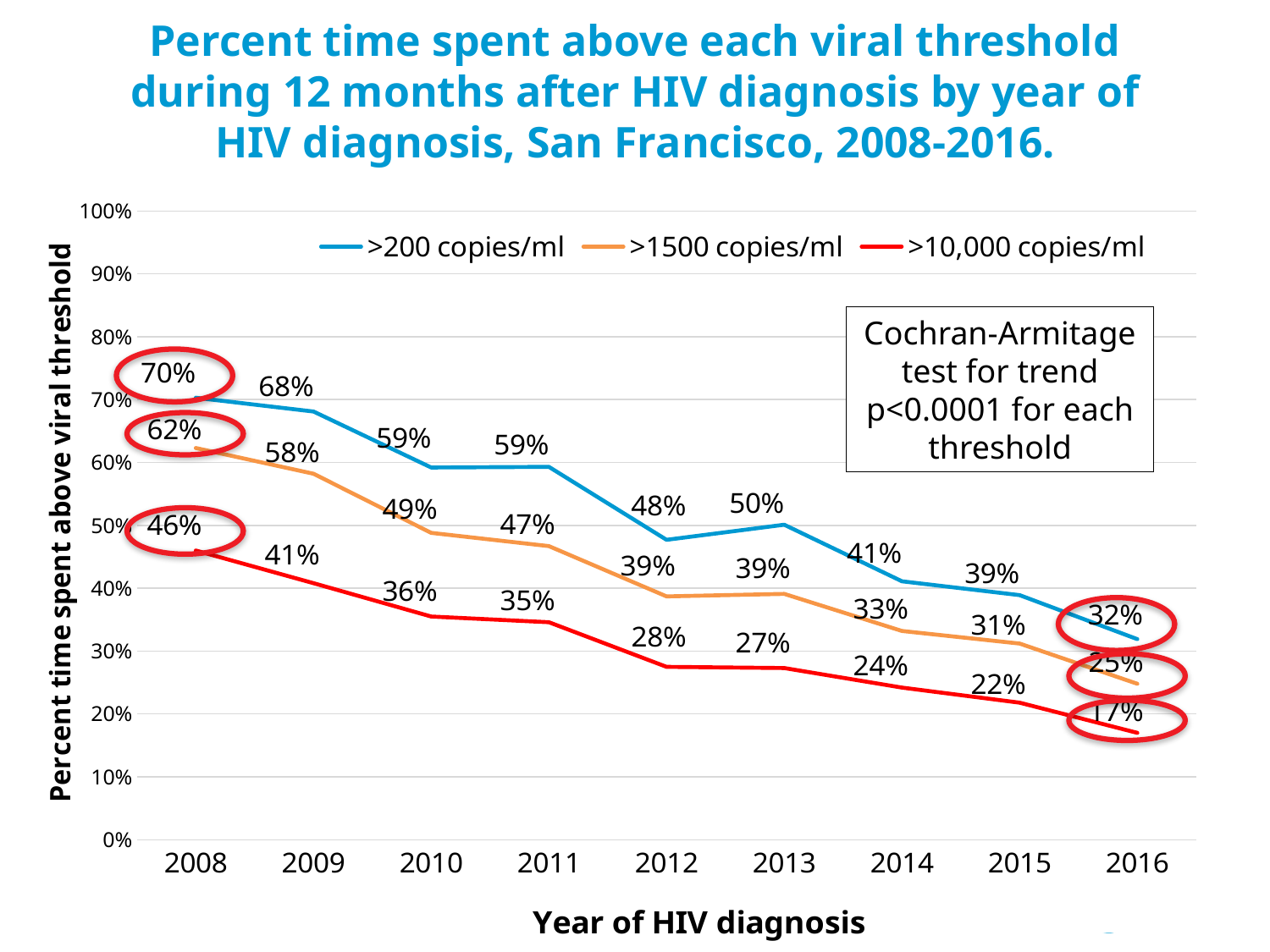
Which is larger in 2013: the >1500 copies/ml value or the >10,000 copies/ml value? >1500 copies/ml What is the value for the >200 copies/ml series in 2008? 70% In which year is the >200 copies/ml series highest? 2008 What is the value for the >1500 copies/ml series in 2016? 25% What type of chart is shown on the slide? line chart What is the value for the >10,000 copies/ml series in 2012? 28% How many series does the legend list? 3 What is the label of the y axis? Percent time spent above viral threshold Do the values for the >1500 copies/ml series generally rise or fall from 2008 to 2016? fall What is the difference between the >200 copies/ml value in 2008 and in 2016? 38% How many years are plotted along the x axis? 9 In which year is the >10,000 copies/ml series lowest? 2016